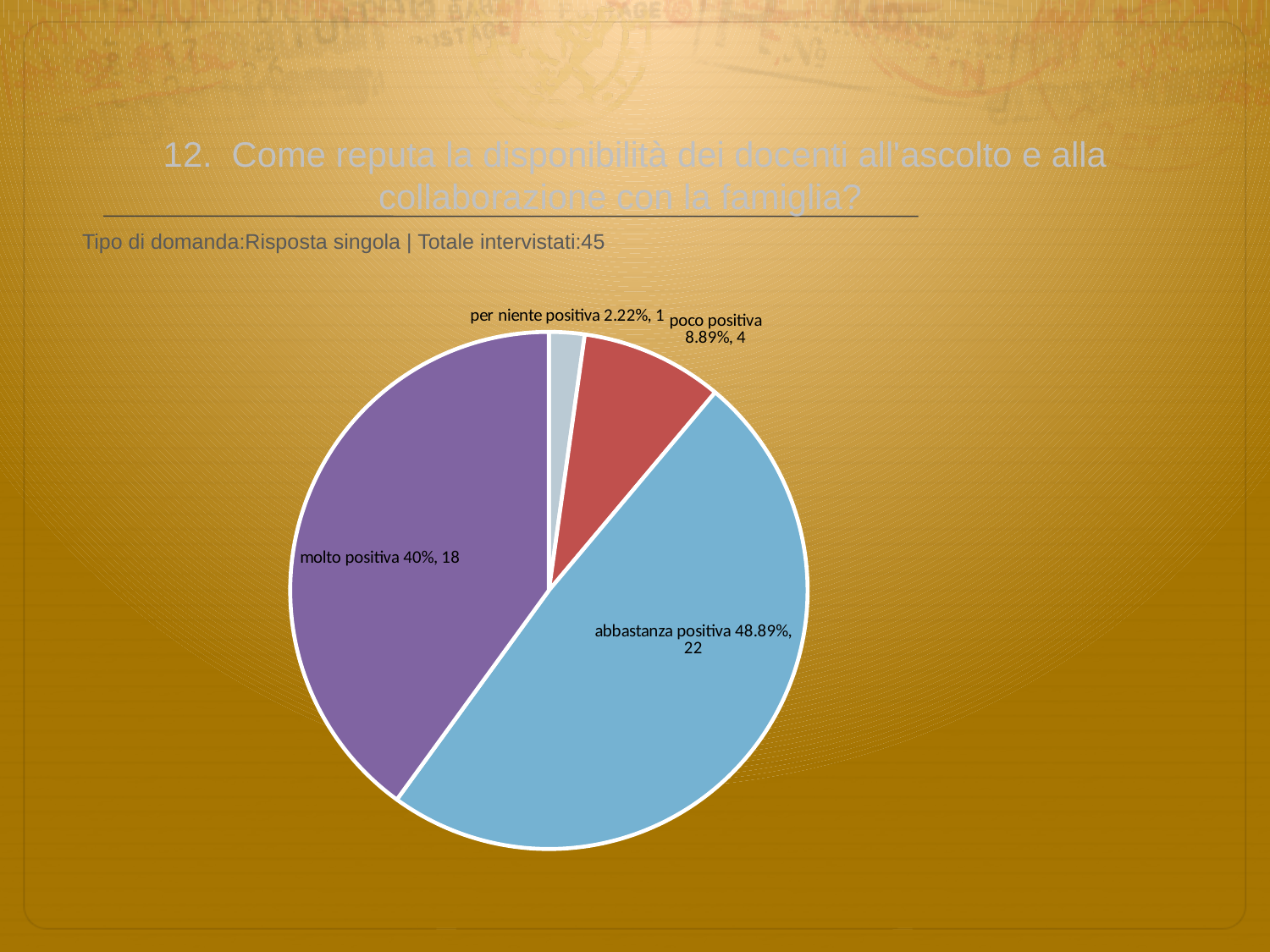
What percentage share does "abbastanza positiva" have? 48.89% What percentage share does "molto positiva" have? 40% Which category has the largest slice? abbastanza positiva What is the count for "abbastanza positiva"? 22 What is the count for "poco positiva"? 4 What percentage share does "per niente positiva" have? 2.22% How many slices does the pie chart have? 4 What kind of chart is shown on the slide? pie chart What is the difference in count between "abbastanza positiva" and "molto positiva"? 4 Which category has the smallest slice? per niente positiva Which is larger, the count for "poco positiva" or for "per niente positiva"? poco positiva What is the total number of respondents stated on the slide? 45